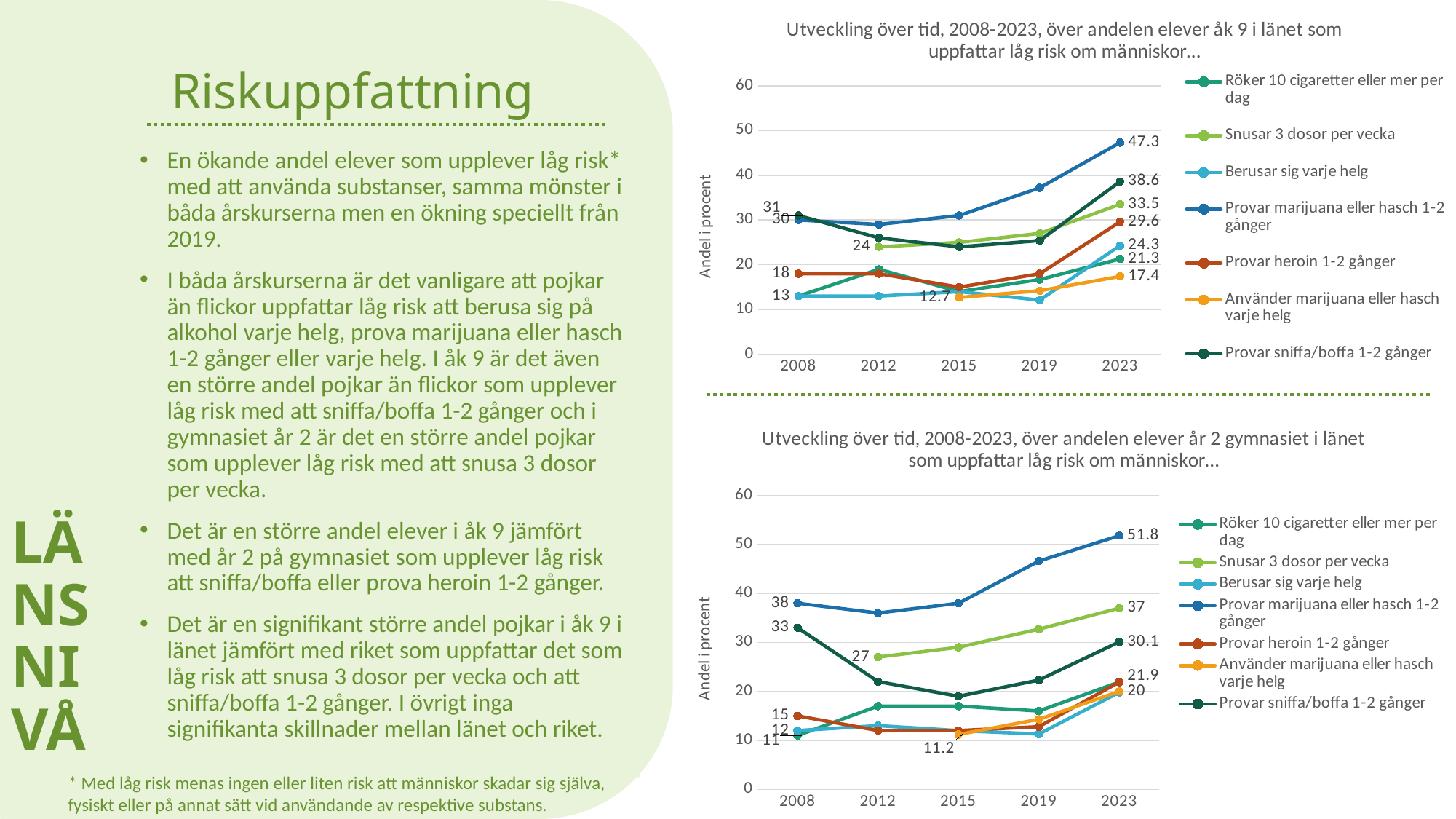
In the bottom chart (år 2 gymnasiet), is the value for 'Snusar 3 dosor per vecka' in 2019 greater or less than 30? greater In the top chart (åk 9), what is the value for 'Provar marijuana eller hasch 1-2 gånger' in 2023? 47.3 In the bottom chart (år 2 gymnasiet), is the value for 'Provar marijuana eller hasch 1-2 gånger' larger in 2008 or in 2023? 2023 In the top chart (åk 9), what is the difference between the 2023 values for 'Provar marijuana eller hasch 1-2 gånger' (47.3) and 'Provar sniffa/boffa 1-2 gånger' (38.6)? 8.7 What kind of chart is the top chart (åk 9)? Line chart How many series does the legend of the top chart (åk 9) list? 7 In the bottom chart (år 2 gymnasiet), what is the value for 'Provar marijuana eller hasch 1-2 gånger' in 2023? 51.8 In the top chart (åk 9), which series has the highest value in 2023? Provar marijuana eller hasch 1-2 gånger In the top chart (åk 9), which series has the lowest value in 2023? Använder marijuana eller hasch varje helg In the bottom chart (år 2 gymnasiet), does the value for 'Provar marijuana eller hasch 1-2 gånger' rise or fall from 2012 to 2023? Rise In the bottom chart (år 2 gymnasiet), what is the value for 'Snusar 3 dosor per vecka' in 2023? 37 How many years are shown on the x axis of the top chart (åk 9)? 5